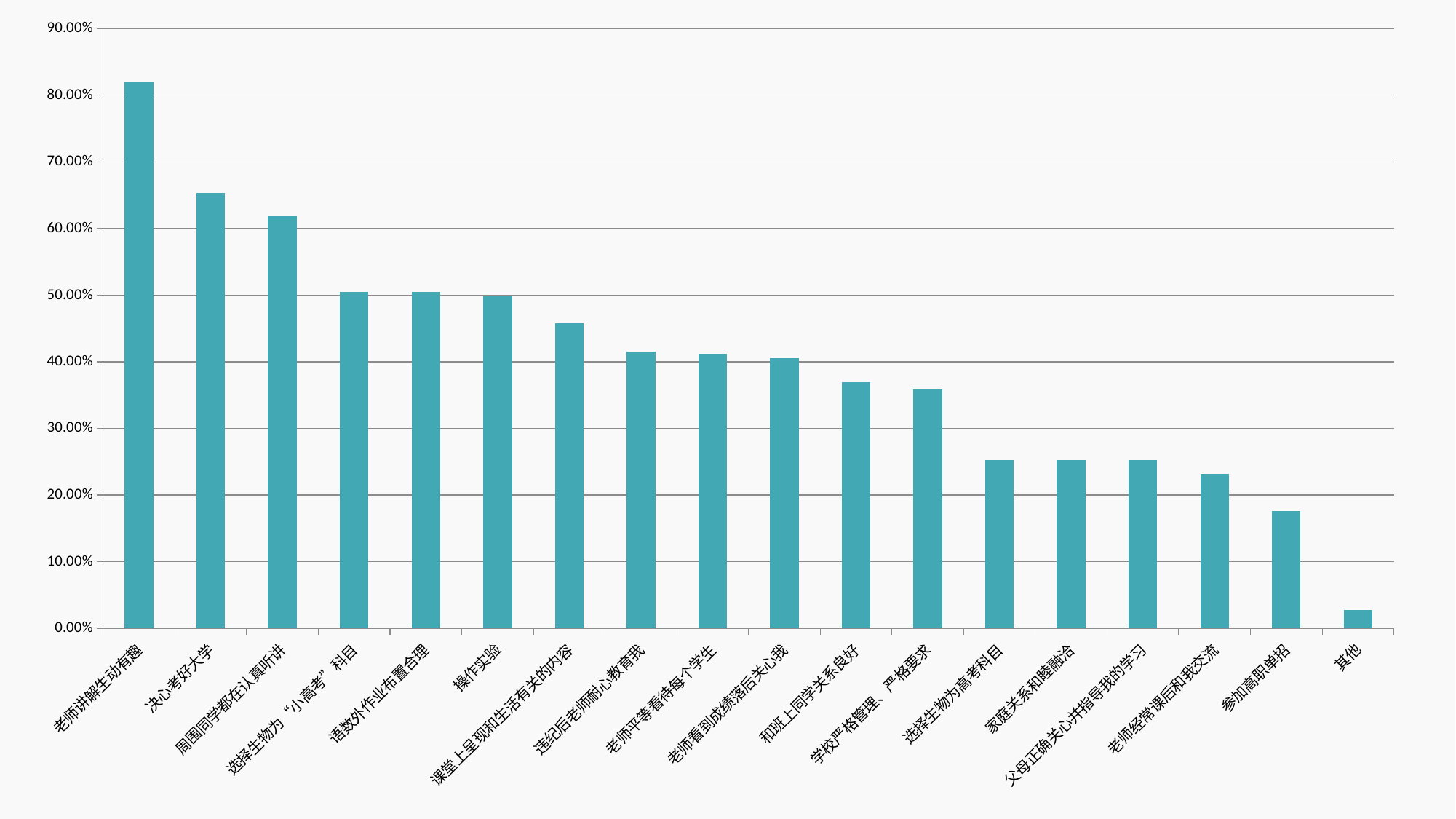
Is the value for 决心考好大学 greater or less than 60.00%? greater What colour are the bars in the chart? teal Which is larger, the value for 决心考好大学 or the value for 周围同学都在认真听讲? 决心考好大学 Which category has the lowest value? 其他 Do the values generally rise or fall moving from left to right along the x axis? fall Is the value for 老师讲解生动有趣 greater or less than 80.00%? greater Is the value for 和班上同学关系良好 greater or less than 40.00%? less What kind of chart is shown on the slide? bar chart Which category has the highest value? 老师讲解生动有趣 How many categories (bars) are plotted in the chart? 18